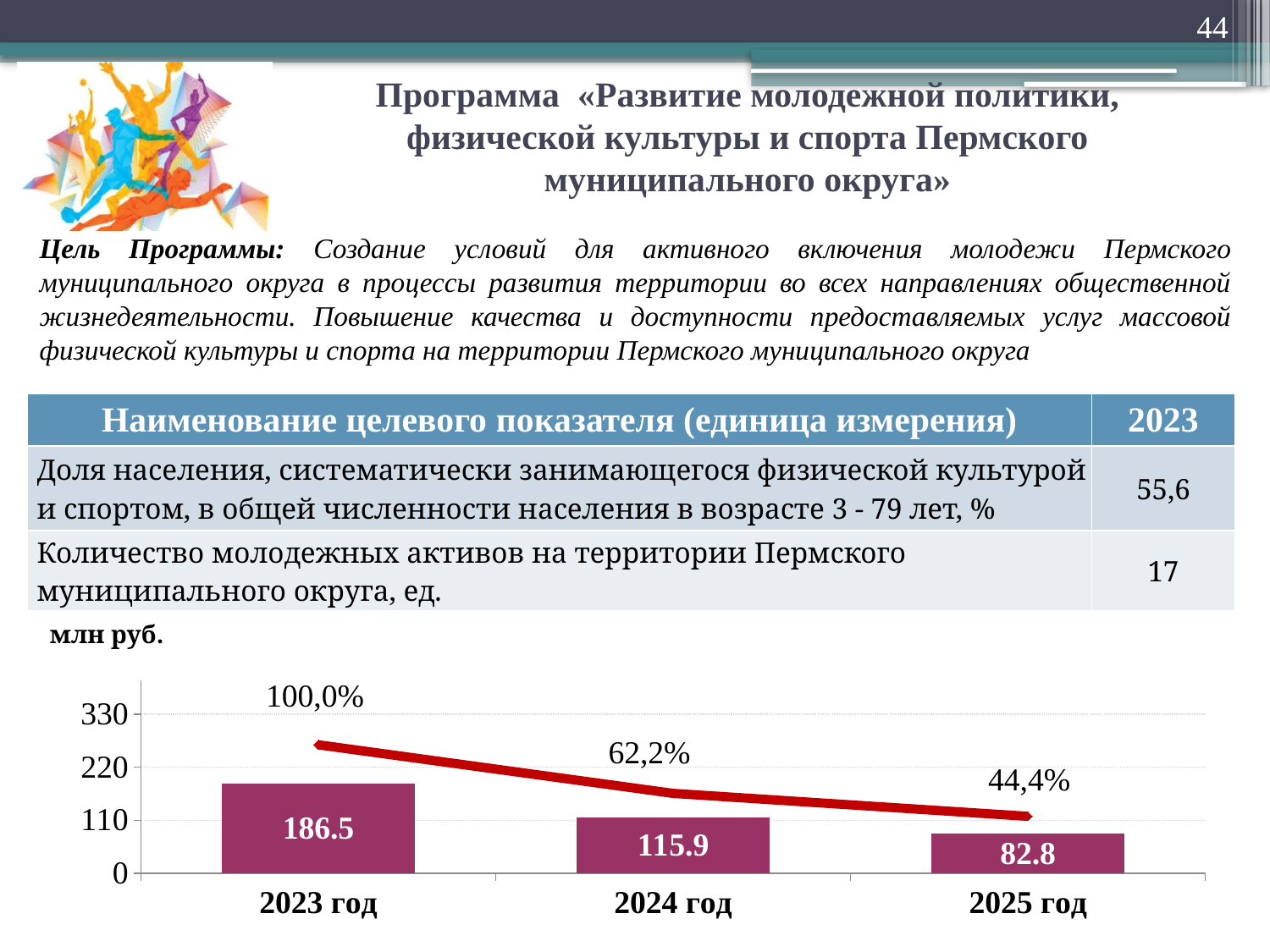
What percentage label is shown on the line above 2024 год? 62,2% How many years are shown on the x axis of the chart? 3 What is the value for 2023 год in the bar chart? 186.5 Which is larger, the value for 2024 год or the value for 2025 год? 2024 год What is the value for 2025 год in the bar chart? 82.8 What is the difference between the values for 2023 год and 2025 год? 103.7 Do the bar values rise or fall from 2023 год to 2025 год? fall What kind of chart is shown at the bottom of the slide? combination bar and line chart What is the value for 2024 год in the bar chart? 115.9 Which year has the highest bar in the chart? 2023 год Which year has the lowest bar in the chart? 2025 год Is the value for 2023 год greater or less than 110? greater